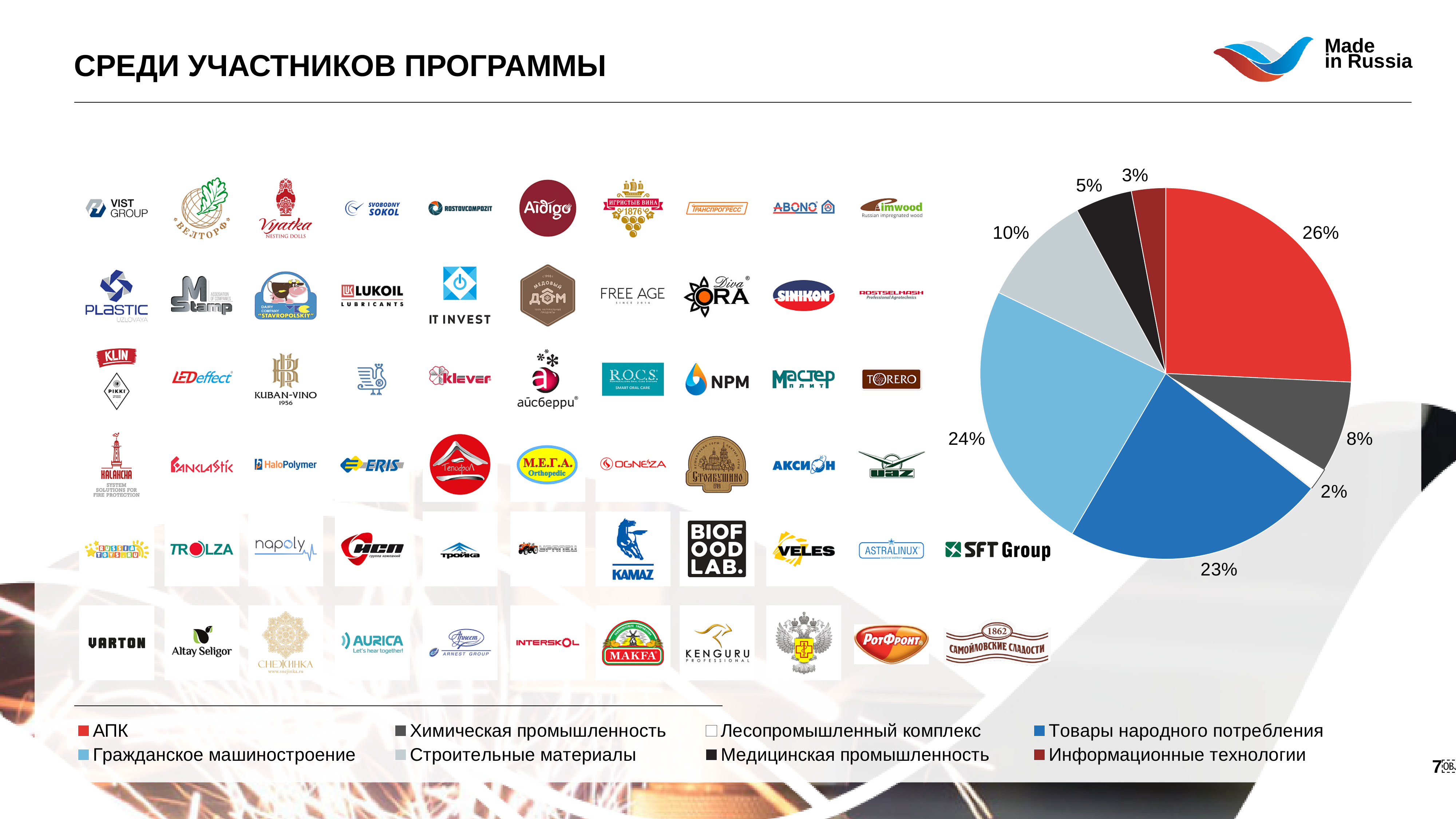
How many entries does the legend list? 8 Which category has the smallest slice of the pie chart? Лесопромышленный комплекс What is the difference between the shares of Химическая промышленность and Медицинская промышленность? 3% What share of the pie chart does АПК have? 26% What kind of chart is shown on the slide? pie chart What share of the pie chart does Товары народного потребления have? 23% What share of the pie chart does Лесопромышленный комплекс have? 2% Which category has the largest slice of the pie chart? АПК Which is larger in the pie chart: Гражданское машиностроение or Товары народного потребления? Гражданское машиностроение What share of the pie chart does Гражданское машиностроение have? 24% How many slices does the pie chart have? 8 What share of the pie chart does Строительные материалы have? 10%